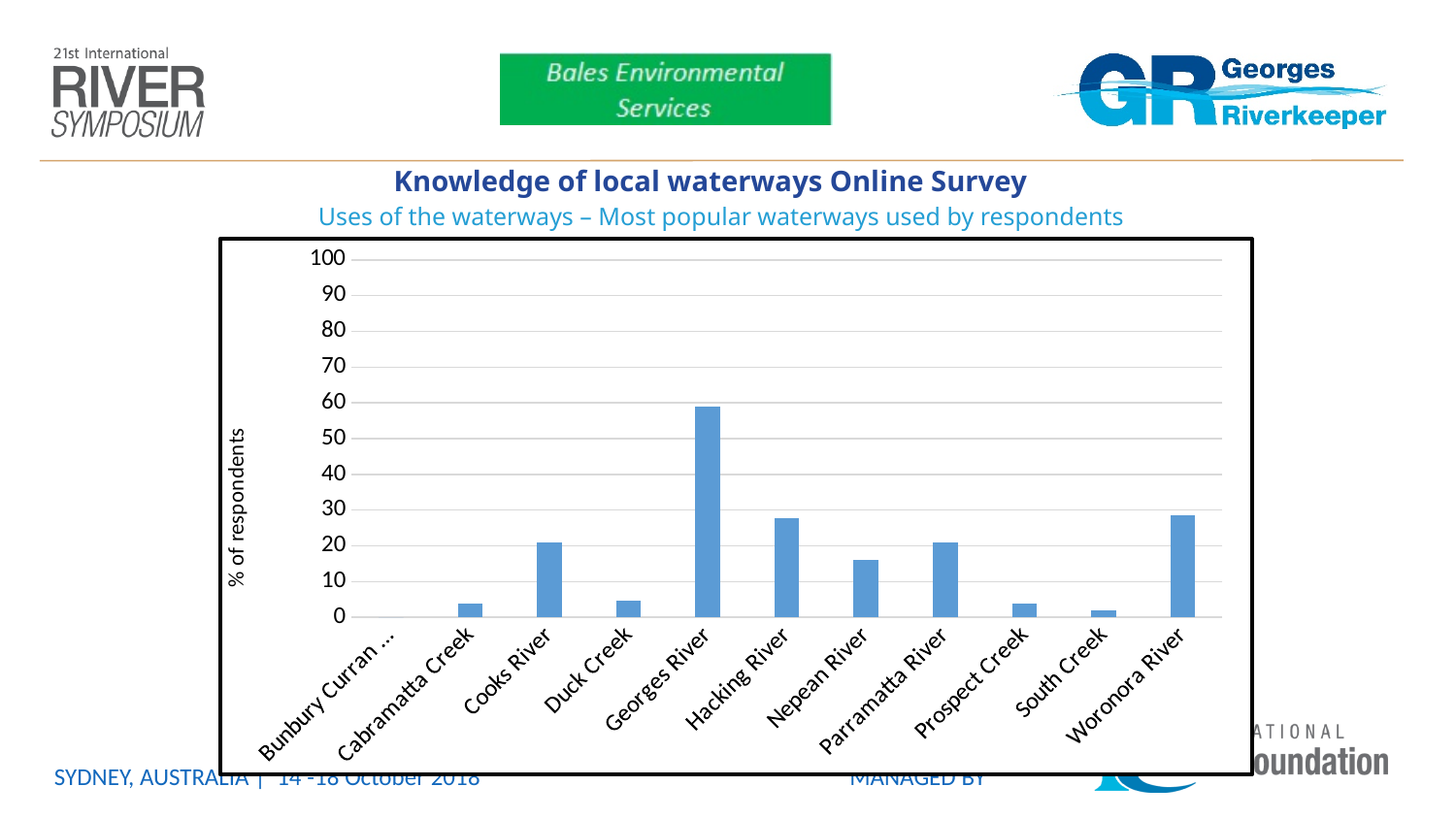
What is the label on the y axis of the chart? % of respondents Is the value for Hacking River greater or less than 30? less What is the subtitle shown above the chart? Uses of the waterways – Most popular waterways used by respondents Is the value for Georges River greater or less than 50? greater Is the value for Nepean River greater or less than 10? greater Which has a higher percentage of respondents, Georges River or Hacking River? Georges River What kind of chart is shown on the slide? bar chart Which waterway has the highest percentage of respondents? Georges River How many waterways are shown on the x axis of the chart? 11 Which has a higher percentage of respondents, Cooks River or Nepean River? Cooks River